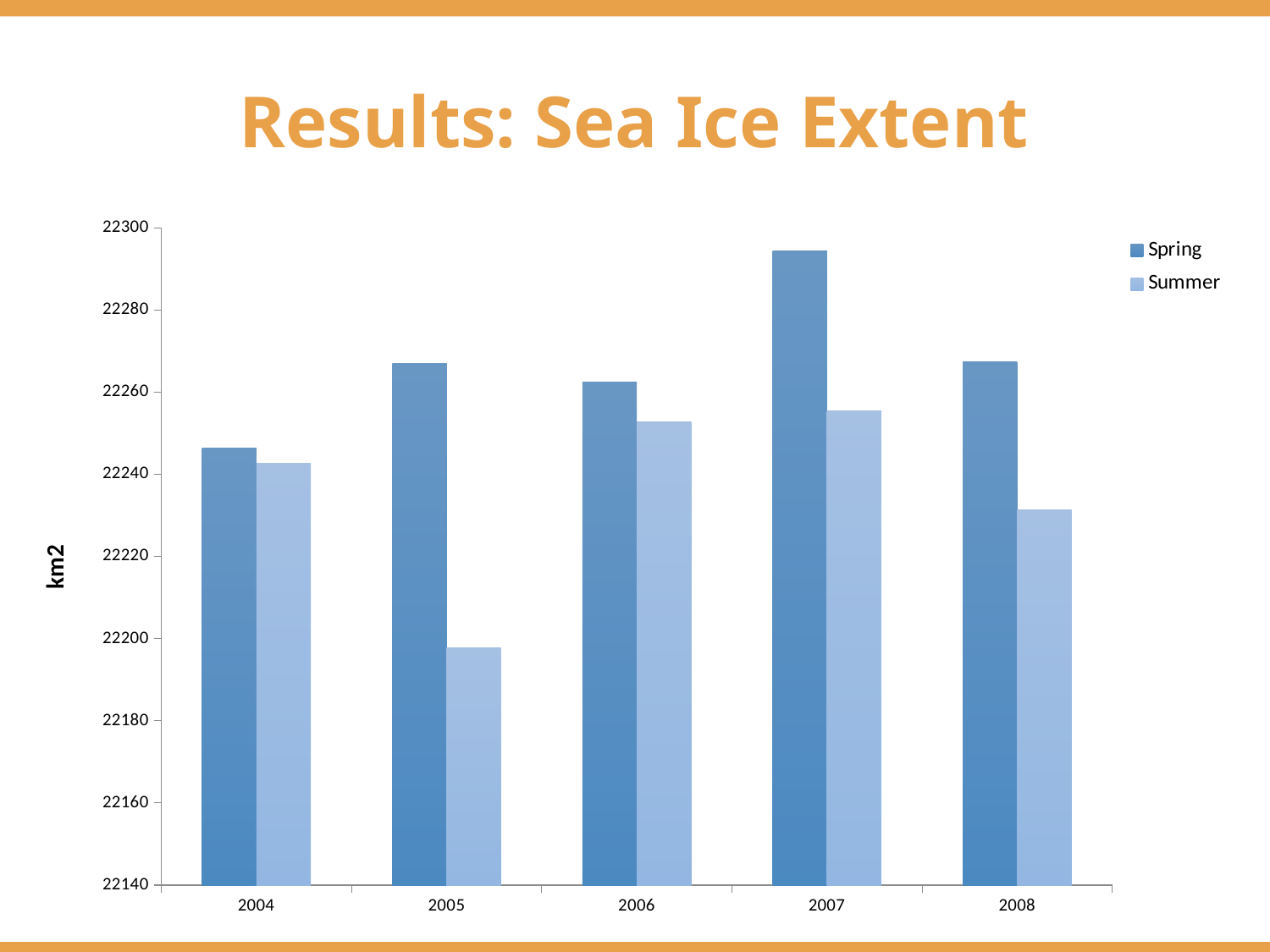
How many series does the legend list? 2 Which year has the highest Spring value? 2007 Is the Summer value for 2005 greater or less than 22200? less Which year has the lowest Summer value? 2005 Which year has the lowest Spring value? 2004 In 2005, which is larger, the Spring value or the Summer value? Spring What is the label on the vertical axis? km2 Is the Spring value for 2007 greater or less than 22280? greater Is the Summer value for 2008 greater or less than 22220? greater How many years are shown on the x axis? 5 What kind of chart is shown on the slide? bar chart Which is larger, the Summer value for 2004 or the Summer value for 2008? 2004